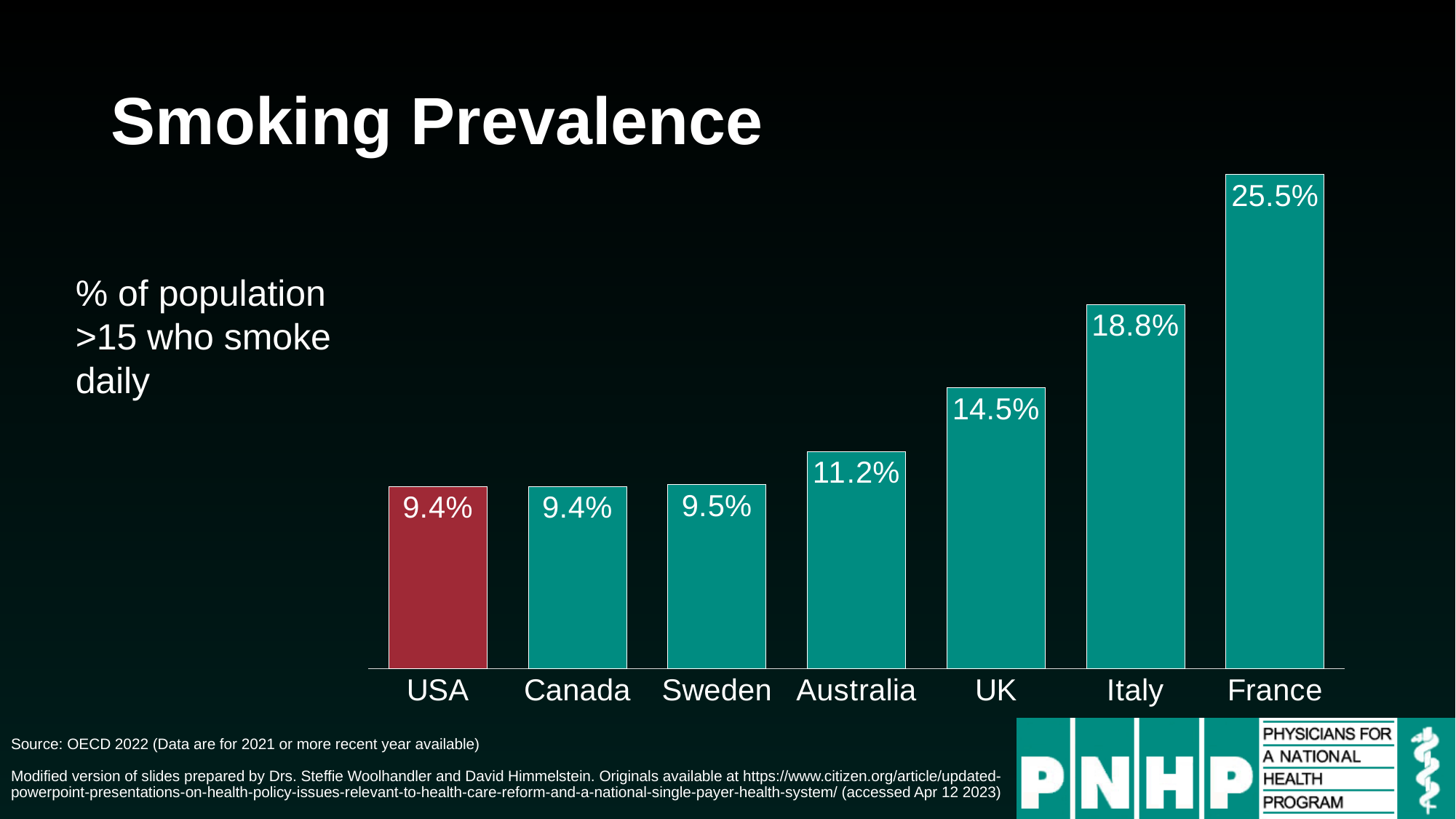
What is the smoking prevalence value shown for Australia? 11.2% What is the difference between the values for the UK and the USA? 5.1% What is the smoking prevalence value shown for the UK? 14.5% What is the title of the chart on the slide? Smoking Prevalence What kind of chart is shown on the slide? Bar chart Which country's bar is coloured differently (red) from the others? USA What is the difference between the values for France and Italy? 6.7% Do the values rise or fall moving from USA to France along the x axis? Rise How many countries are shown on the chart? 7 Which country has the highest smoking prevalence on the chart? France Which has a larger value, Italy or Australia? Italy What is the smoking prevalence value shown for France? 25.5%